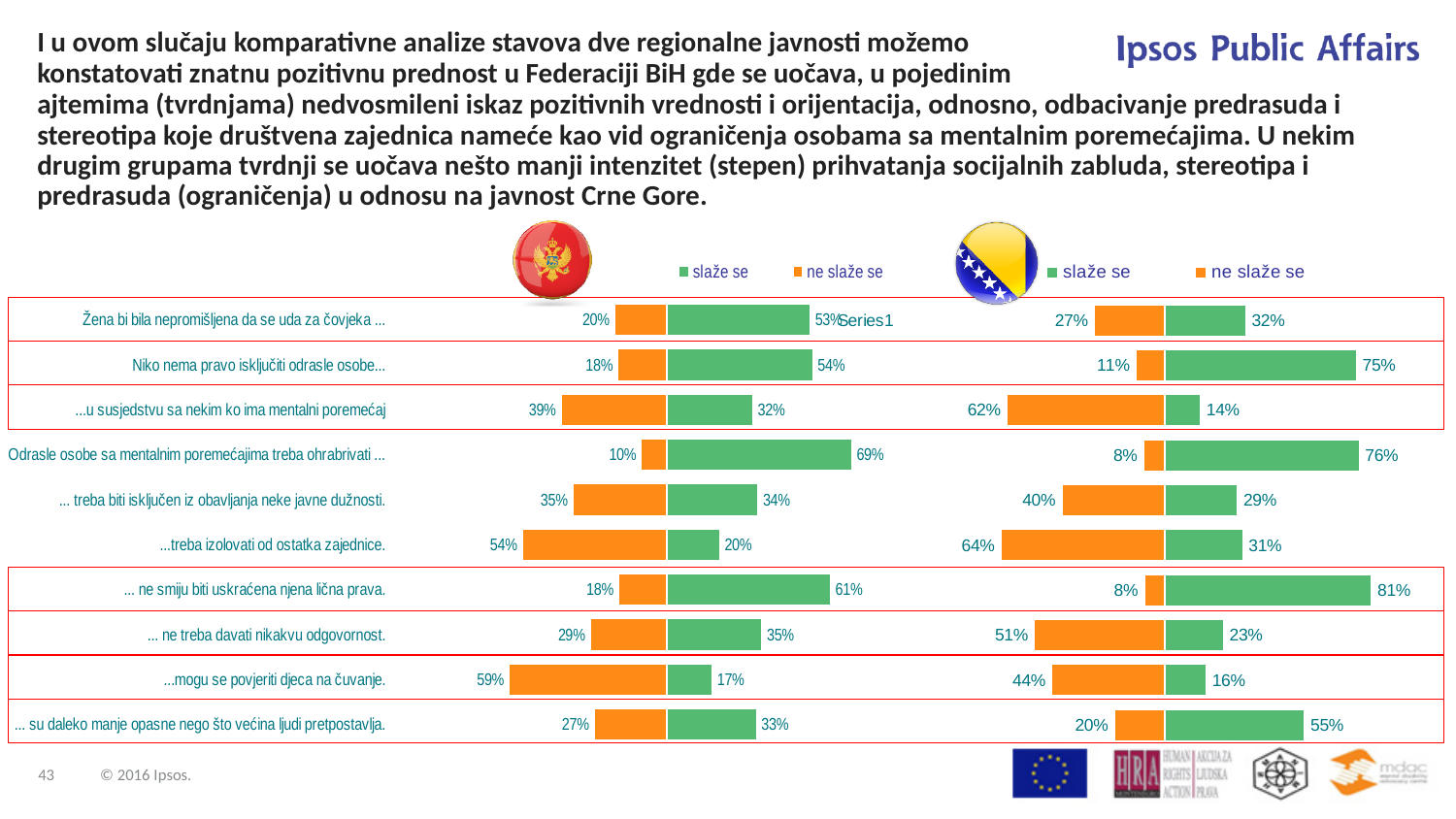
In the right chart, what is the 'slaže se' value for 'Niko nema pravo isključiti odrasle osobe...'? 75% In the right chart, which category has the highest 'slaže se' value? ... ne smiju biti uskraćena njena lična prava. How many series does the legend of the right chart list? 2 In the left chart, what is the difference between the 'slaže se' and 'ne slaže se' values for '... ne smiju biti uskraćena njena lična prava.'? 43% In the left chart, what is the 'ne slaže se' value for '...mogu se povjeriti djeca na čuvanje.'? 59% For '...u susjedstvu sa nekim ko ima mentalni poremećaj', which chart shows the larger 'ne slaže se' value, the left or the right? right In the right chart, which colour represents 'ne slaže se'? orange In the left chart, what is the 'slaže se' value for 'Odrasle osobe sa mentalnim poremećajima treba ohrabrivati ...'? 69% How many categories are shown in the left chart? 10 What type of chart is the left chart? bar chart In the right chart, what is the 'ne slaže se' value for '...treba izolovati od ostatka zajednice.'? 64% In the left chart, which category has the lowest 'ne slaže se' value? Odrasle osobe sa mentalnim poremećajima treba ohrabrivati ...